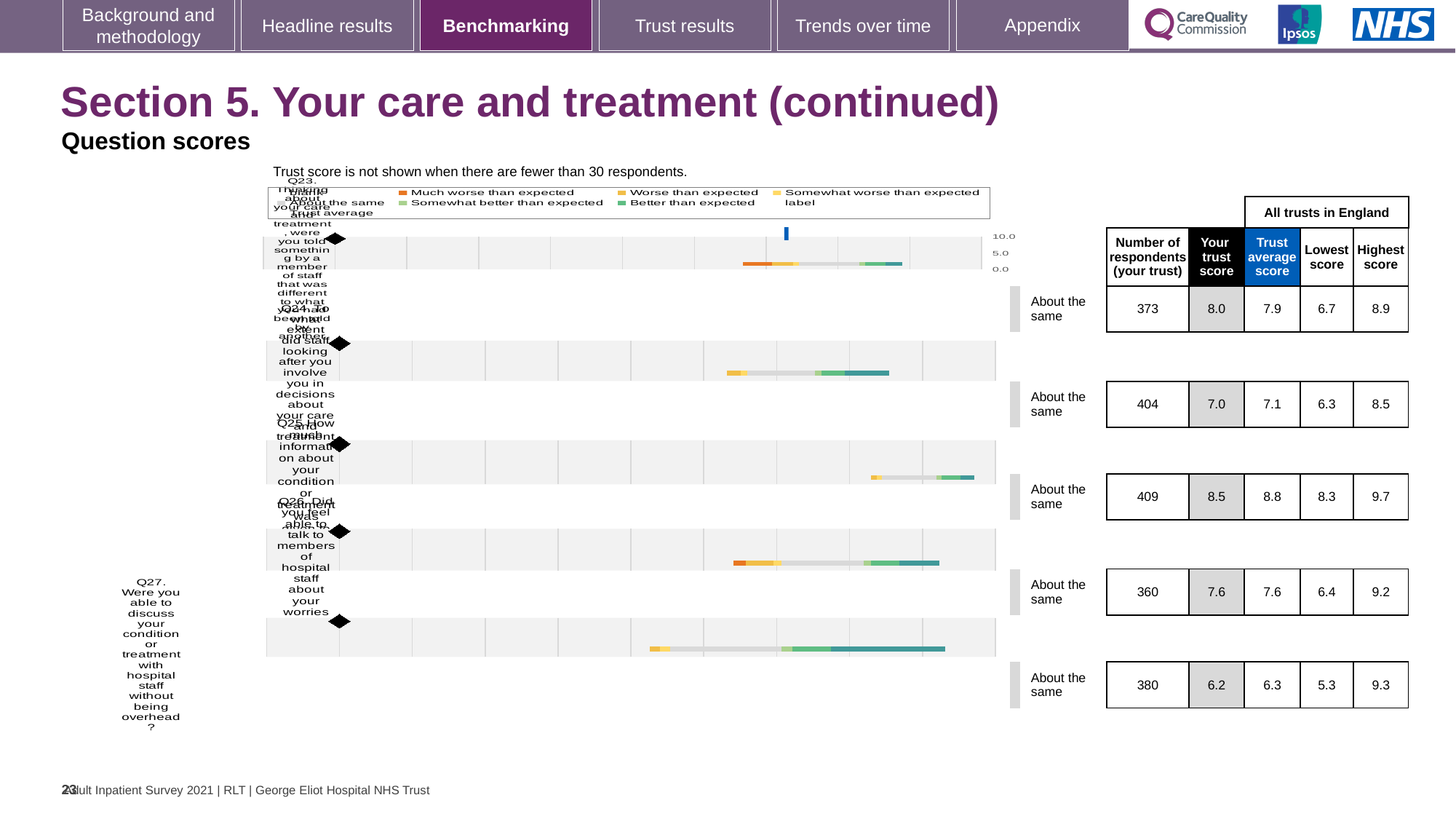
For Q25, what is the difference between the trust average score and your trust score? 0.3 How many questions are shown in the benchmarking chart? 5 How many respondents from your trust answered Q23? 373 What is the lowest score across all trusts in England for Q27? 5.3 For Q23, which is larger: your trust score or the trust average score? Your trust score What is the trust average score for Q25? 8.8 Which question has the lowest 'Your trust score'? Q27 What is your trust score for Q24? 7.0 Which question has the highest 'Your trust score'? Q25 What is the highest score across all trusts in England for Q26? 9.2 What benchmarking category is shown for every question on this slide? About the same What kind of chart is used to show the question scores? Bar chart